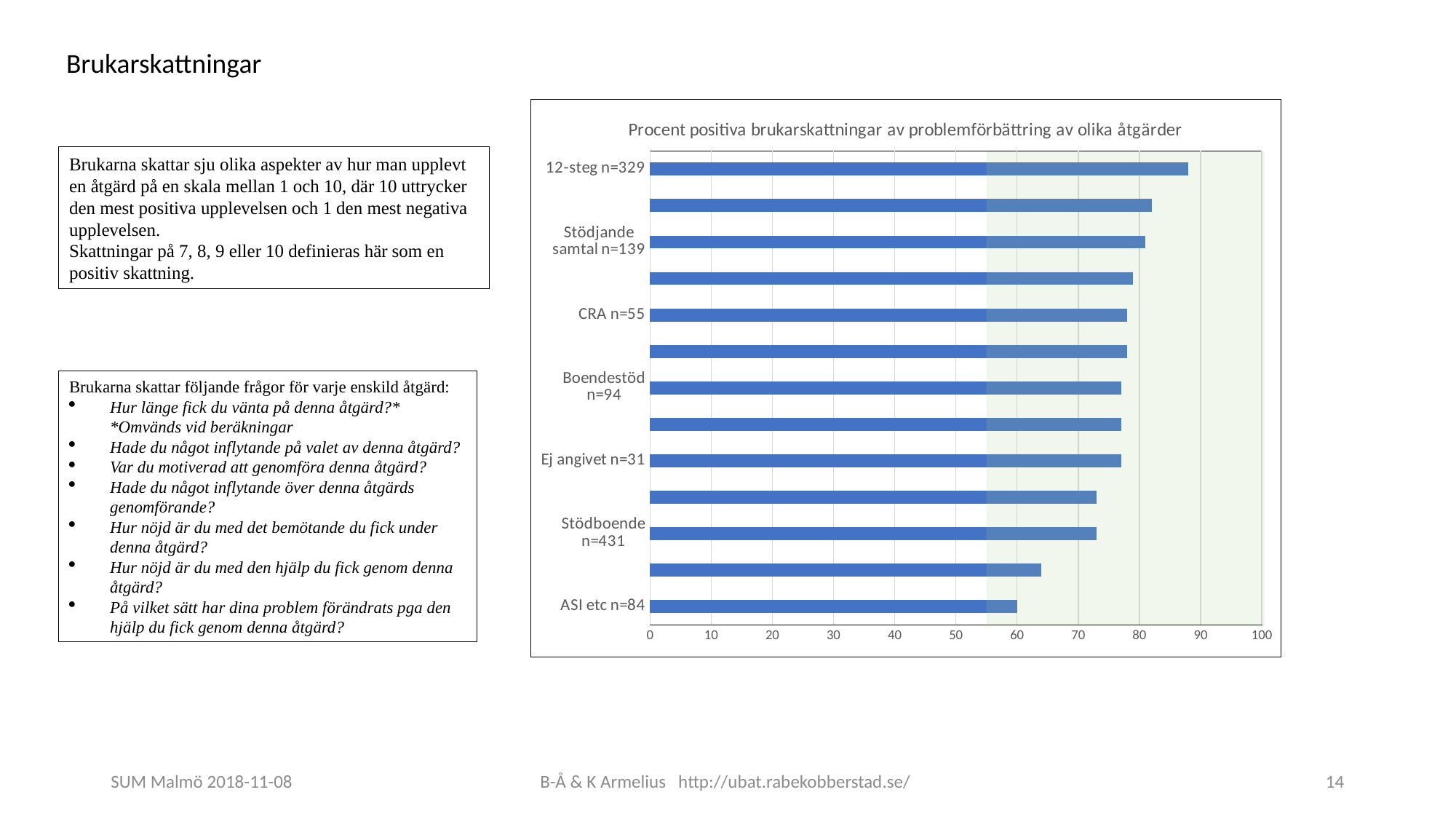
What kind of chart is shown on the slide? Bar chart Which has a larger value, 12-steg n=329 or ASI etc n=84? 12-steg n=329 Is the value for CRA n=55 greater or less than 70? greater Which labelled category has the lowest value in the chart? ASI etc n=84 Which has a larger value, CRA n=55 or Stödboende n=431? CRA n=55 What is the maximum value shown on the horizontal axis of the chart? 100 Is the value for Stödboende n=431 greater or less than 80? less Is the value for 12-steg n=329 greater or less than 80? greater Which labelled category has the highest value in the chart? 12-steg n=329 What is the title of the chart? Procent positiva brukarskattningar av problemförbättring av olika åtgärder